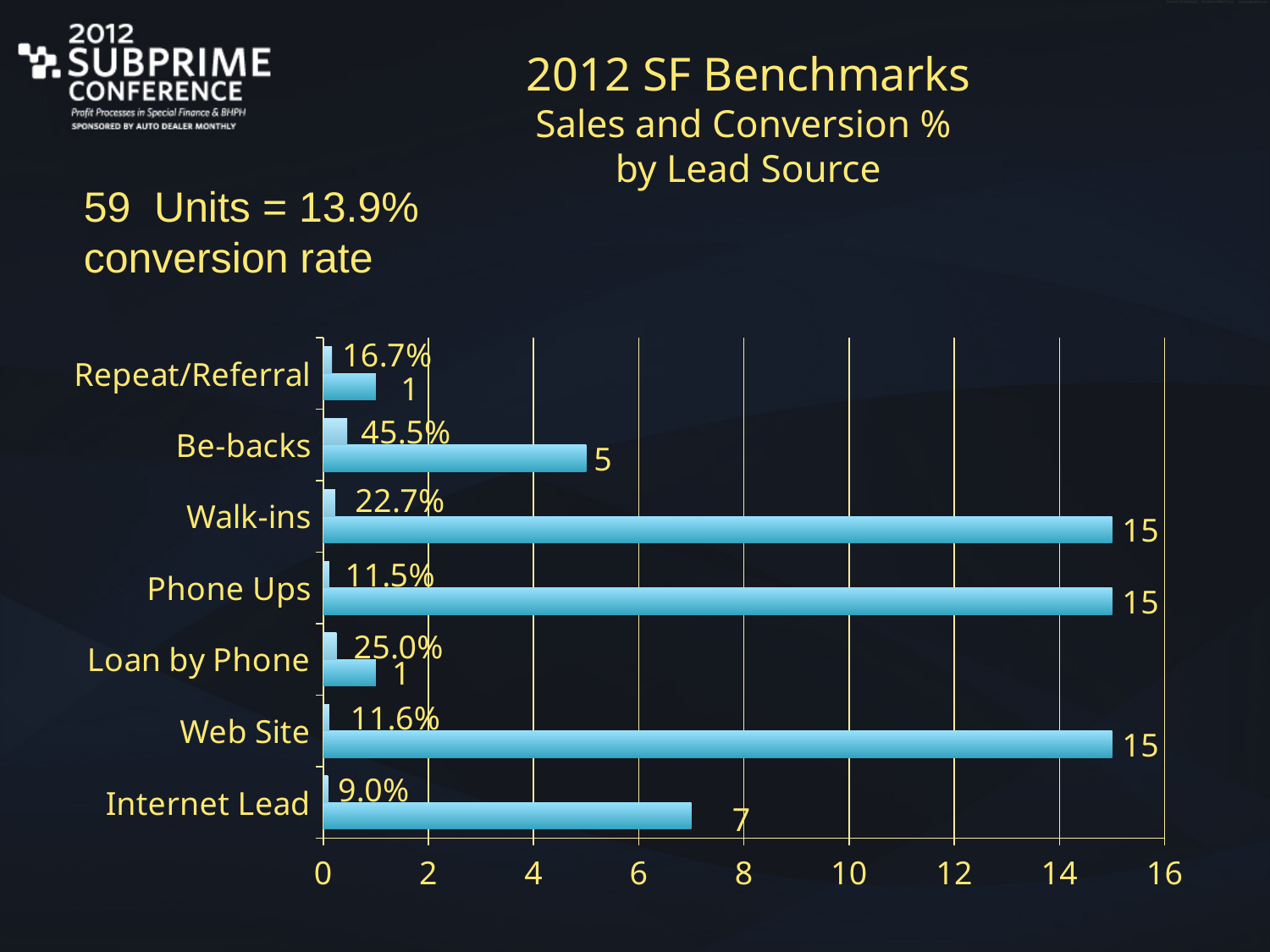
Which has more units, Internet Lead or Be-backs? Internet Lead What is the number of units for Walk-ins? 15 How many lead source categories are shown on the chart? 7 What kind of chart is shown on the slide? bar chart Which lead source has the highest conversion percentage? Be-backs What is the difference in units between Walk-ins and Be-backs? 10 What is the title of the chart? 2012 SF Benchmarks Sales and Conversion % by Lead Source Which lead source has the lowest conversion percentage? Internet Lead What is the conversion percentage for Phone Ups? 11.5% Is the units value for Web Site greater or less than 10? greater What is the conversion percentage for Be-backs? 45.5% What is the number of units for Internet Lead? 7